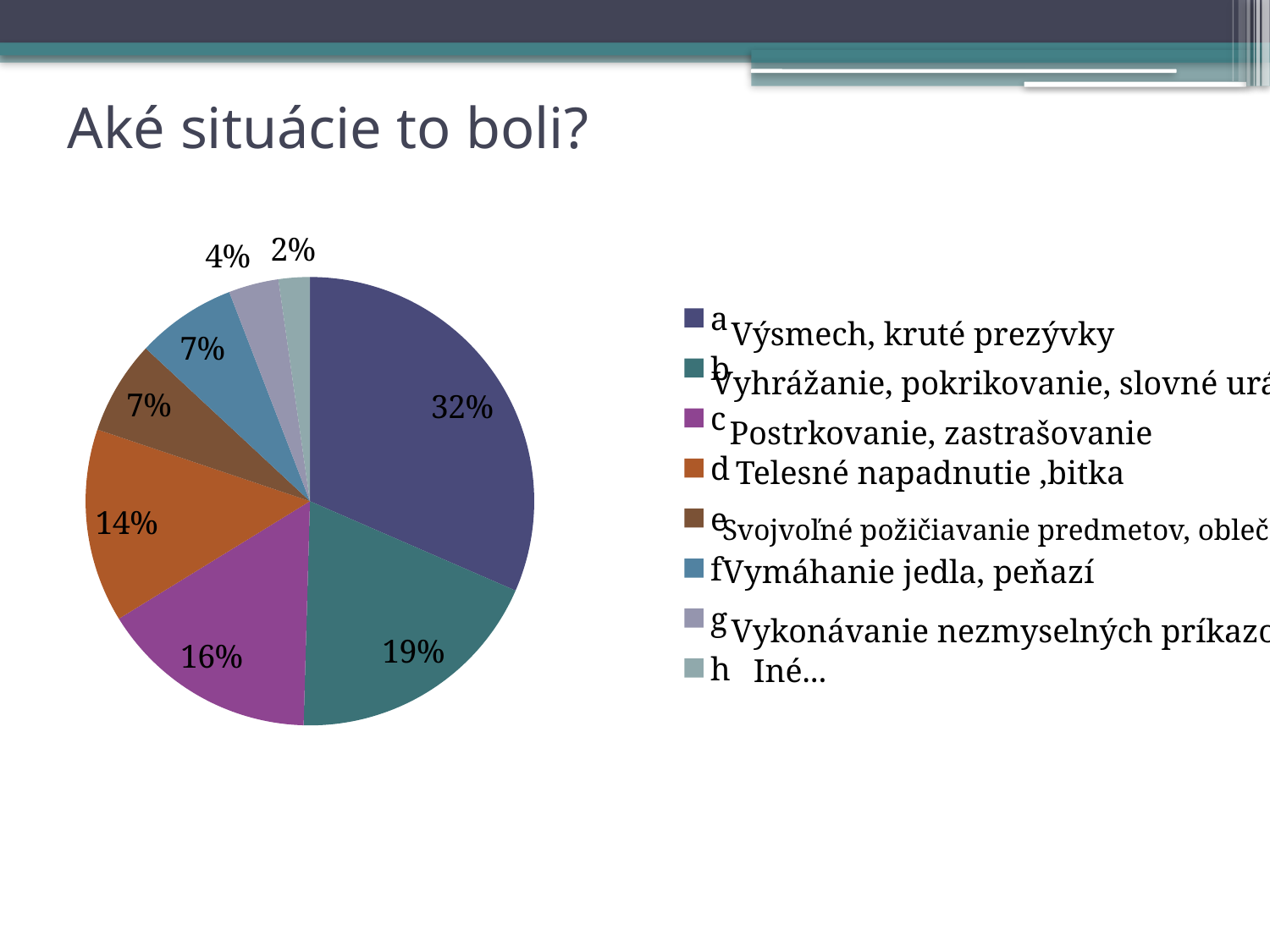
Which is larger, the slice for category c or the slice for category d? c What share of the pie does category a (Výsmech, kruté prezývky) have? 32% What is the value shown for category c (Postrkovanie, zastrašovanie)? 16% Which category has the smallest slice of the pie? h (Iné...) Which category has the largest slice of the pie? a (Výsmech, kruté prezývky) What is the value shown for category g (Vykonávanie nezmyselných príkazov)? 4% What kind of chart is shown on the slide? pie chart What is the value shown for category f (Vymáhanie jedla, peňazí)? 7% How many slices does the pie chart have? 8 What is the value shown for category d (Telesné napadnutie, bitka)? 14% What is the title of the slide with the pie chart? Aké situácie to boli? What is the difference between the share of category a and the share of category b? 13%